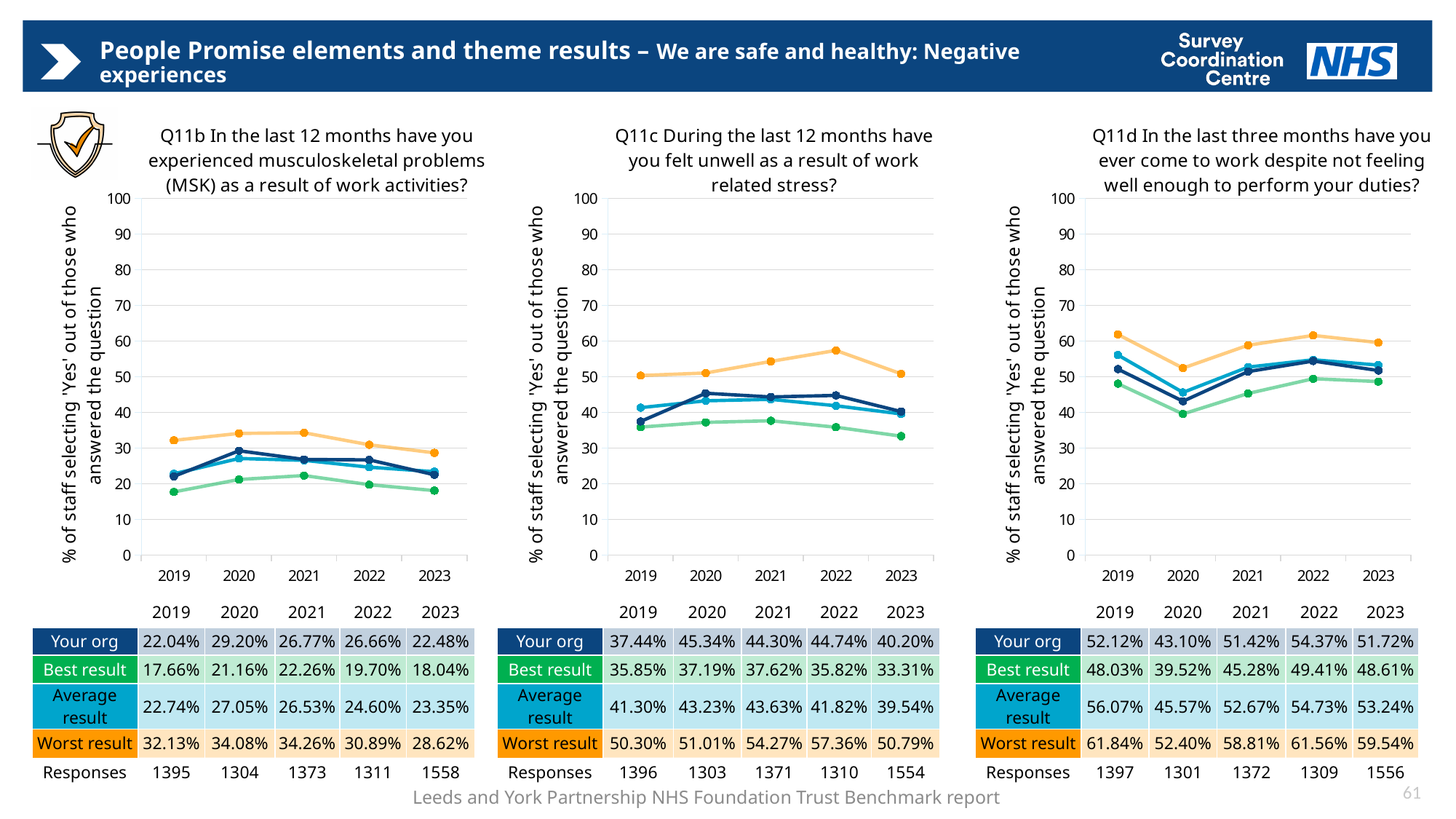
How many years are plotted on the x axis of the Q11c chart? 5 On the Q11d chart, in which year is the Best result lowest? 2020 On the Q11b chart, does the Worst result rise or fall from 2021 to 2023? Fall How many series are shown on the Q11d chart? 4 On the Q11c chart, what is the difference between the Your org value and the Best result value in 2023? 6.89 percentage points On the Q11d chart, what is the Worst result value for 2019? 61.84% What type of chart is used for Q11b? Line chart On the Q11c chart, what is the Average result value for 2021? 43.63% On the Q11b chart, is the Worst result value for 2021 greater or less than 30? greater On the Q11c chart, in which year is the Worst result highest? 2022 On the Q11d chart, which is larger in 2019: the Your org value or the Average result value? Average result On the Q11b chart, what is the Your org value for 2020? 29.20%